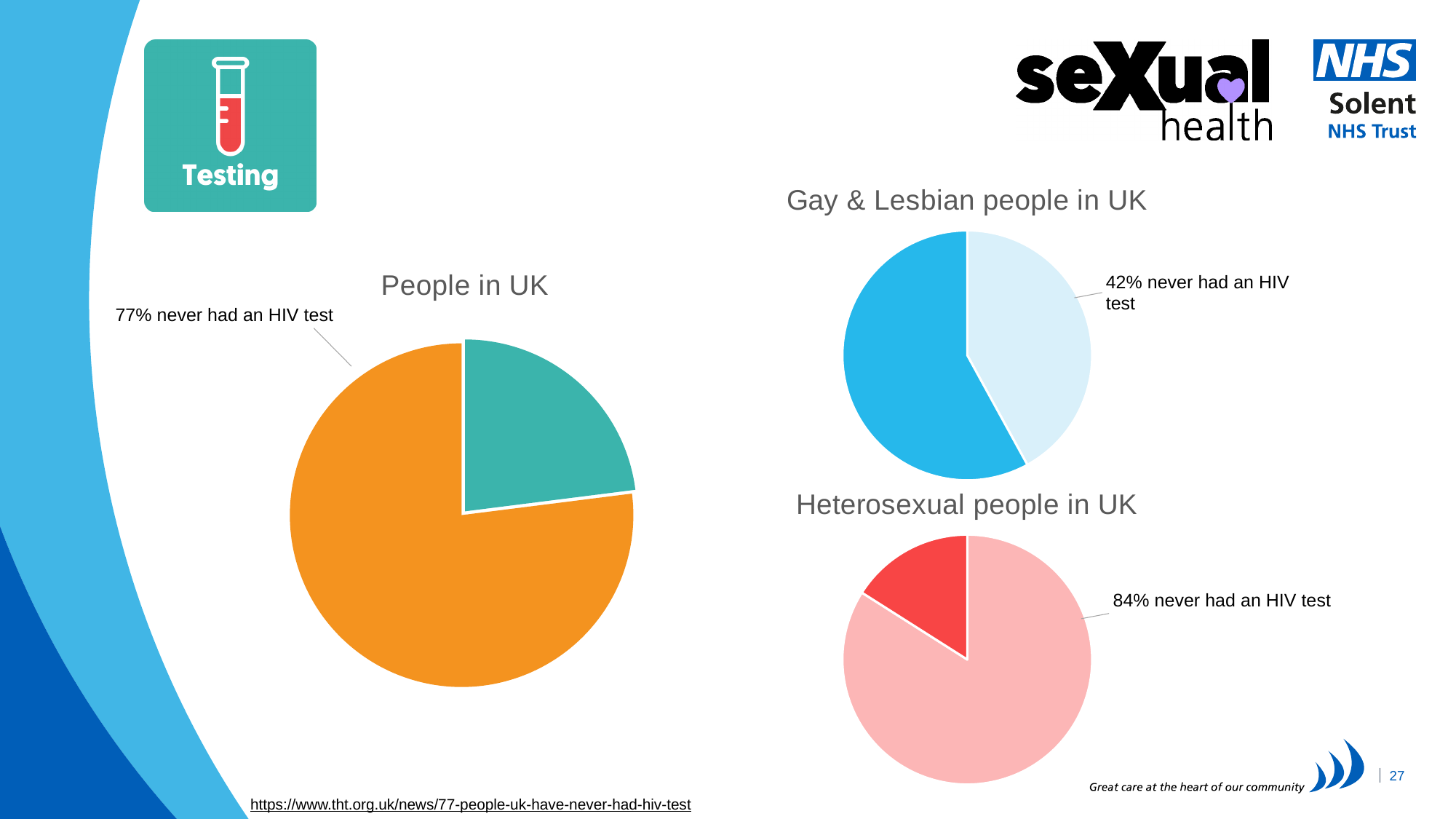
How many pie charts are shown on the slide? 3 In the 'People in UK' pie chart, what colour is the slice labelled '77% never had an HIV test'? Orange Across the three pie charts, which group has the lowest percentage that never had an HIV test? Gay & Lesbian people in UK In the 'Gay & Lesbian people in UK' pie chart, what percentage never had an HIV test? 42% In the 'People in UK' pie chart, what percentage of people never had an HIV test? 77% How many slices does the 'Heterosexual people in UK' pie chart have? 2 What is the difference in percentage points between the 'never had an HIV test' share in the 'Heterosexual people in UK' chart and the 'People in UK' chart? 7 percentage points What is the difference in percentage points between the 'never had an HIV test' share in the 'Heterosexual people in UK' chart and the 'Gay & Lesbian people in UK' chart? 42 percentage points Across the three pie charts, which group has the highest percentage that never had an HIV test? Heterosexual people in UK In the 'Heterosexual people in UK' pie chart, what percentage never had an HIV test? 84% Which is larger: the percentage who never had an HIV test in the 'Heterosexual people in UK' chart or in the 'Gay & Lesbian people in UK' chart? Heterosexual people in UK What kind of chart is the 'People in UK' chart? Pie chart